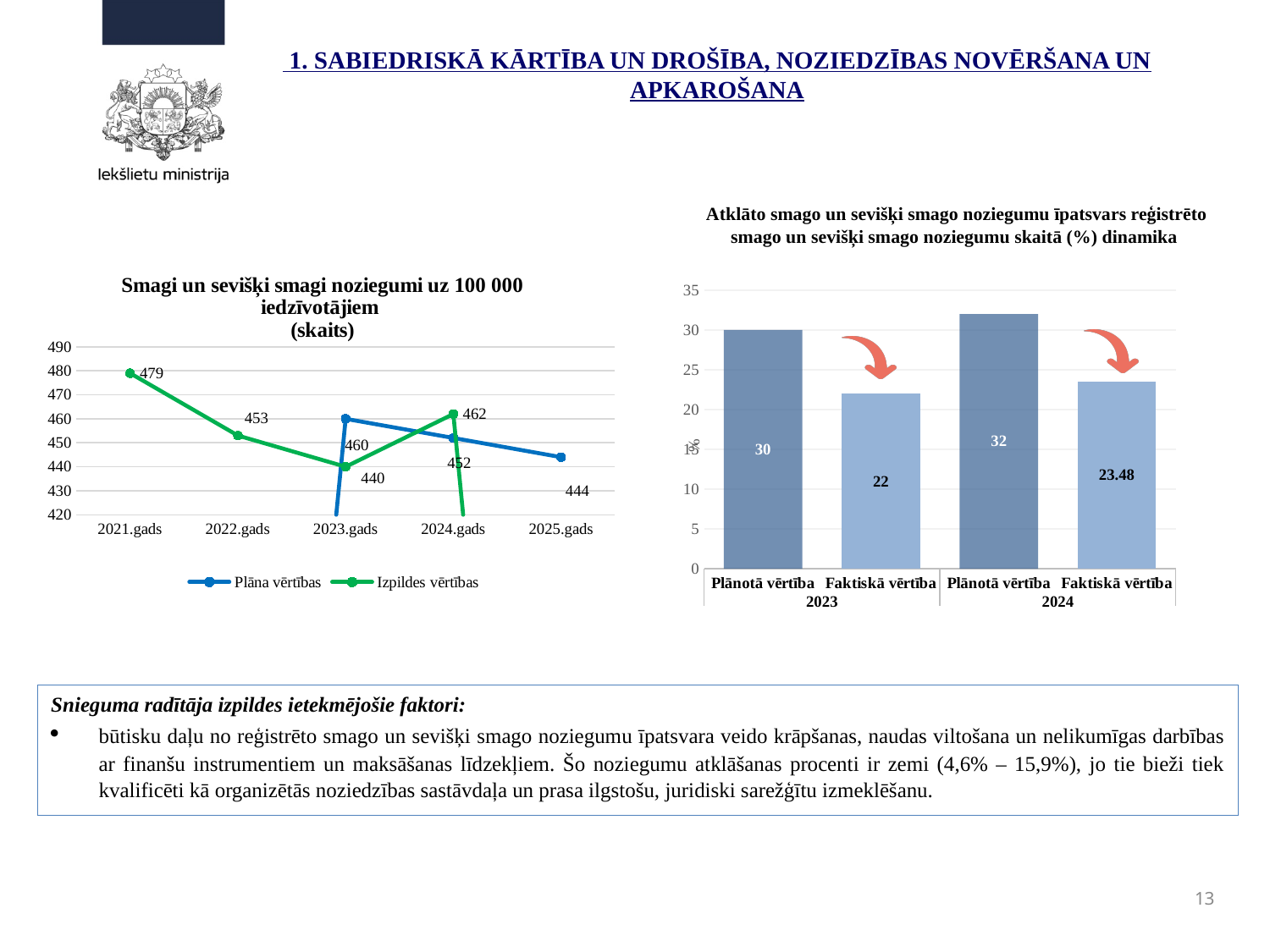
In the bar chart on the right, what is the value for Faktiskā vērtība in 2024? 23.48 In the line chart on the left, which series has the larger value for 2024.gads, Plāna vērtības or Izpildes vērtības? Izpildes vērtības In the bar chart on the right, how many bars are plotted? 4 In the bar chart on the right, what is the value for Plānotā vērtība in 2023? 30 In the line chart on the left, what is the Plāna vērtības value for 2025.gads? 444 In the bar chart on the right, which bar has the highest value? Plānotā vērtība 2024 In the line chart on the left, what is the Izpildes vērtības value for 2021.gads? 479 In the bar chart on the right, which bar has the lowest value? Faktiskā vērtība 2023 In the line chart on the left, how many series does the legend list? 2 In the bar chart on the right, what is the difference between Plānotā vērtība and Faktiskā vērtība for 2023? 8 What kind of chart is the chart on the right of the slide? Bar chart In the line chart on the left, what is the difference between the Plāna vērtības and Izpildes vērtības values for 2023.gads? 20